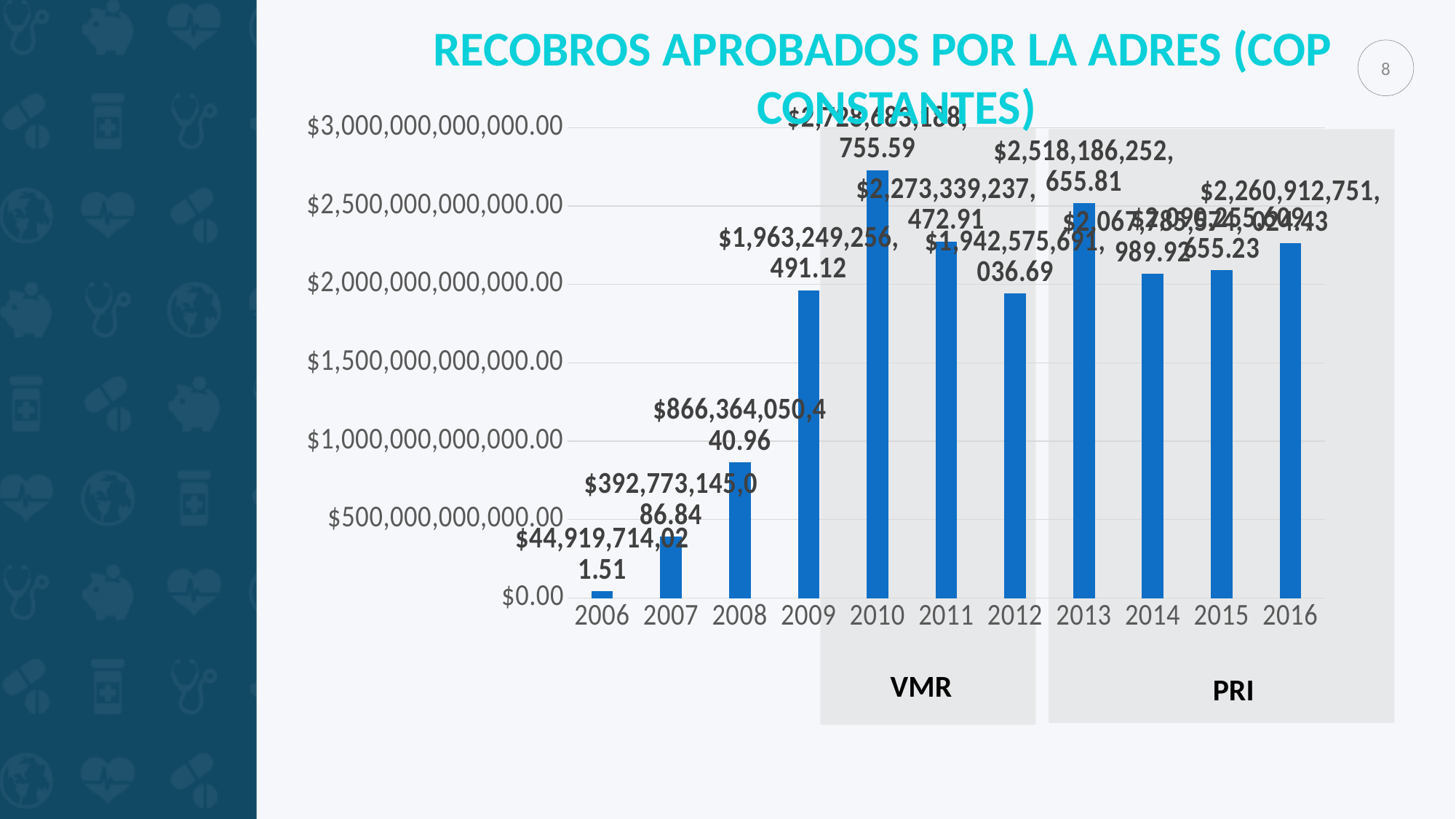
What is the value for 2008? $866,364,050,440.96 What is the difference between the values for 2008 and 2007? $473,590,905,354.12 How many years are shown on the x axis? 11 Is the value for 2016 greater or less than $2,000,000,000,000.00? greater Which year has the lowest value? 2006 What is the value for 2009? $1,963,249,256,491.12 What is the value for 2011? $2,273,339,237,472.91 Which year has the highest value? 2010 What is the value for 2013? $2,518,186,252,655.81 What is the value for 2007? $392,773,145,086.84 Which is larger, the value for 2011 or the value for 2013? 2013 What kind of chart is this? bar chart